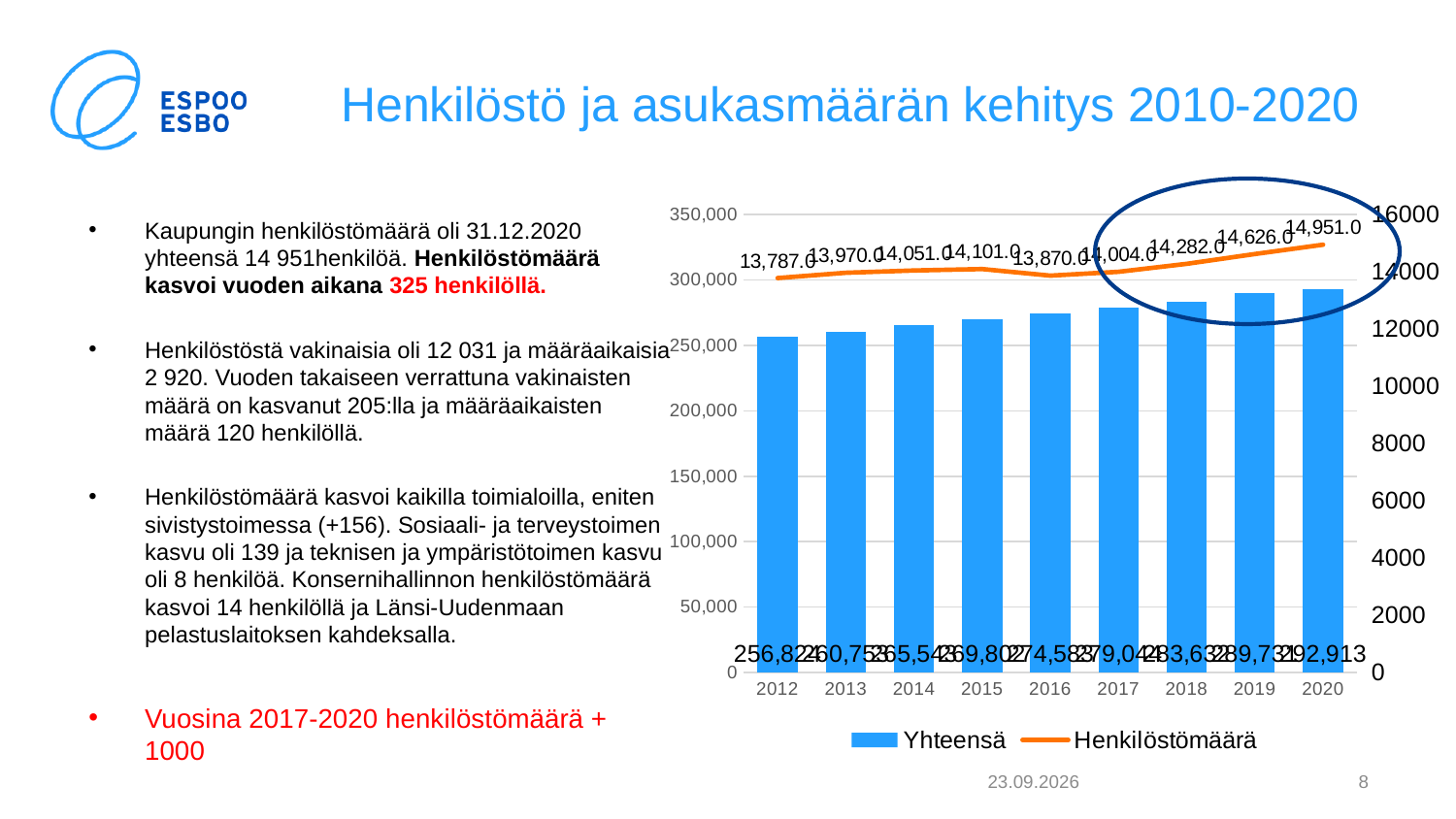
By how much did Henkilöstömäärä increase from 2019 to 2020? 325 How many series does the chart legend list? 2 In which year is the Yhteensä bar the highest? 2020 What is the Henkilöstömäärä value for 2019? 14,626.0 In which year is the Yhteensä bar the lowest? 2012 Which year has the larger Henkilöstömäärä value, 2015 or 2016? 2015 Do the Yhteensä bars rise or fall from 2012 to 2020? Rise Is the Yhteensä value for 2020 greater or less than 300,000? less What kind of chart is shown on the slide? A combined bar and line chart What is the Henkilöstömäärä value for 2020? 14,951.0 What is the Yhteensä value for 2020? 292,913 How many years are shown on the x axis of the chart? 9